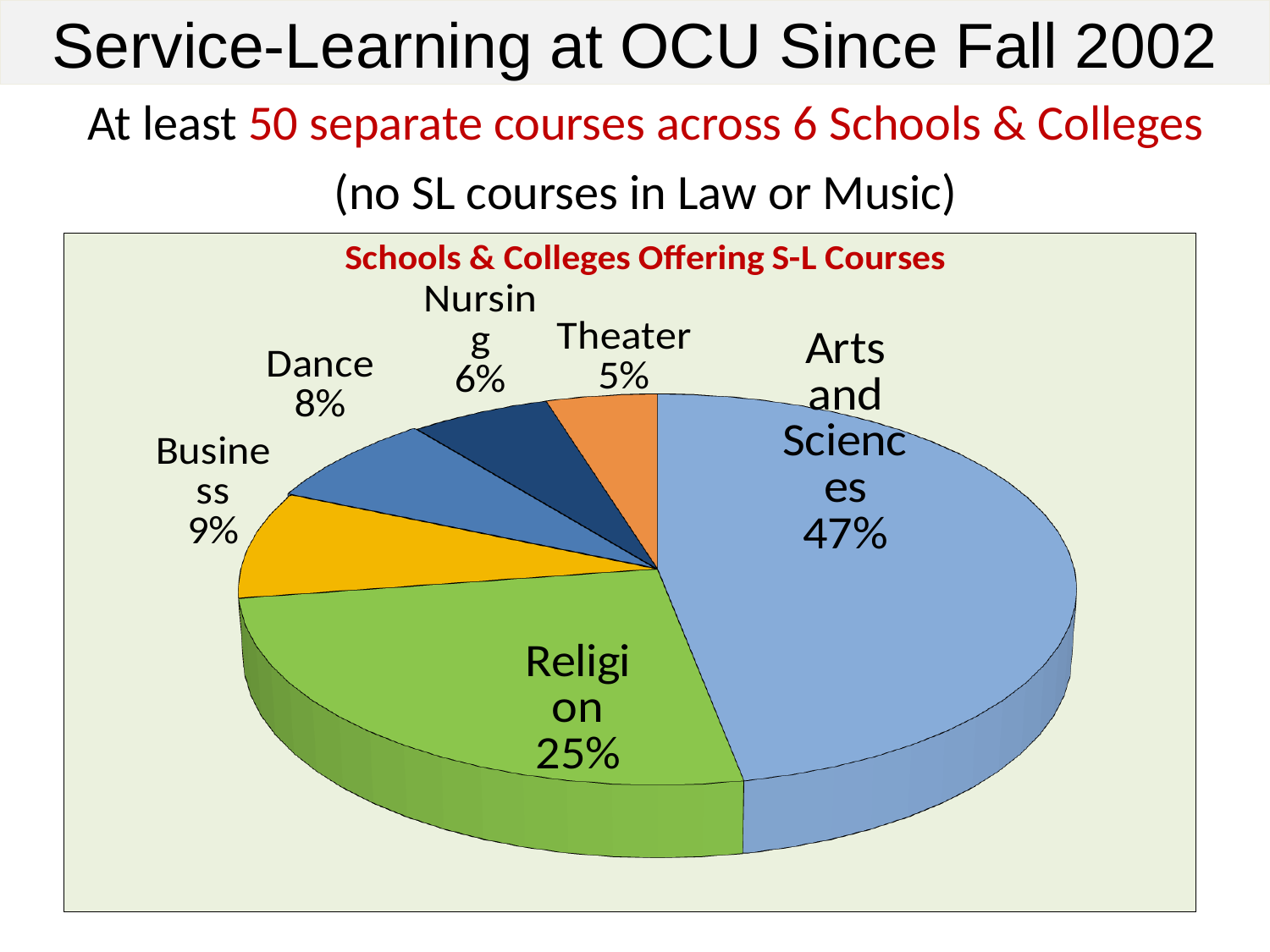
What percentage is shown for Nursing? 6% What is the title of the chart? Schools & Colleges Offering S-L Courses What percentage is shown for Business? 9% What percentage is shown for Religion? 25% What colour is the Religion slice? Green What share of the pie does Arts and Sciences hold? 47% What kind of chart is shown on the slide? Pie chart Which school or college has the smallest slice of the pie? Theater What is the difference in percentage points between Arts and Sciences and Religion? 22 Which is larger, the Dance slice or the Nursing slice? Dance How many slices does the pie chart have? 6 Which school or college has the largest slice of the pie? Arts and Sciences